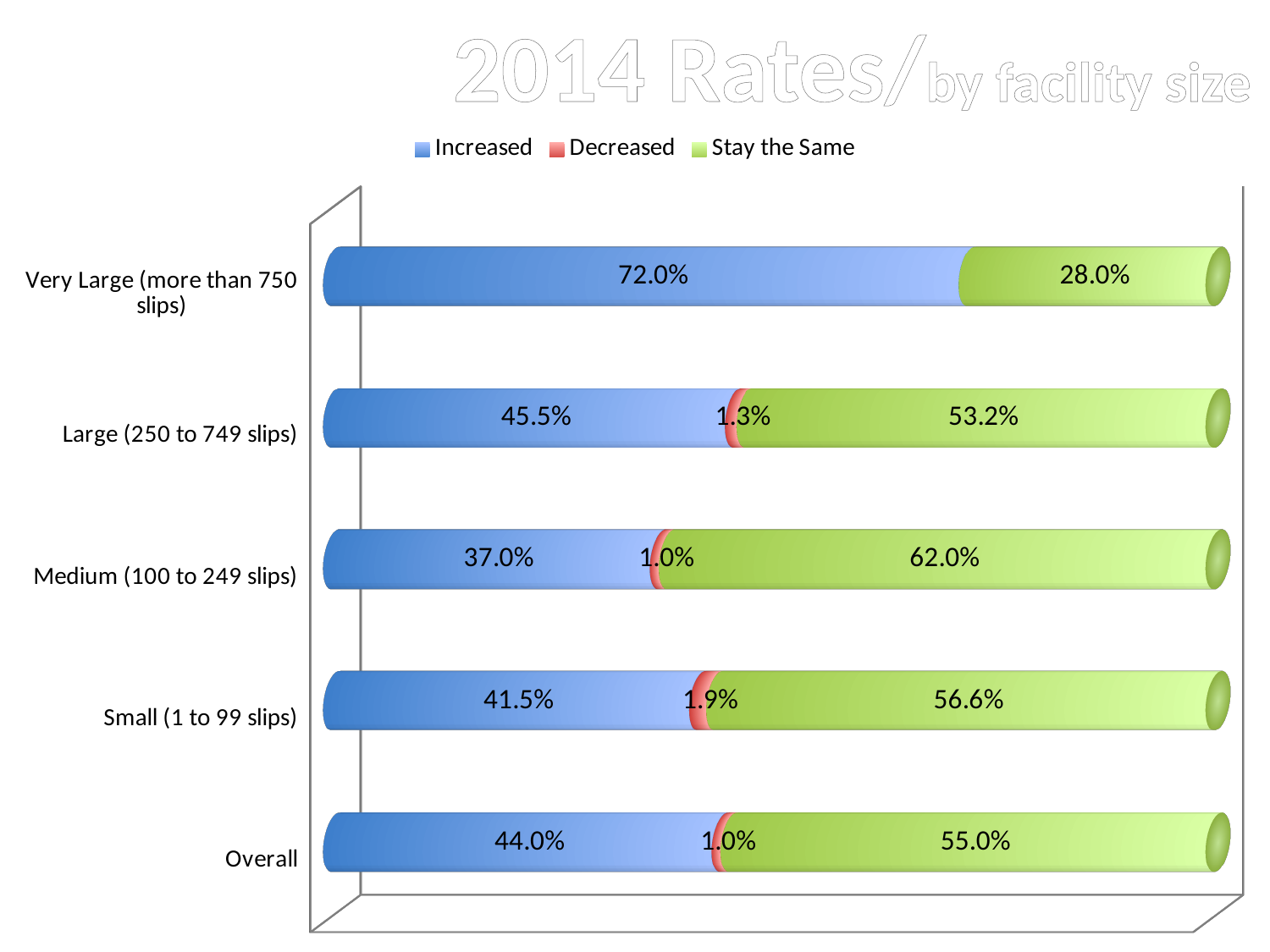
What is the Decreased value for Small facilities (1 to 99 slips)? 1.9% How many series does the legend list? 3 What is the difference between the Stay the Same values for Medium (100 to 249 slips) and Very Large (more than 750 slips)? 34.0% What kind of chart is shown on the slide? Stacked bar chart Which facility size category has the lowest Increased percentage? Medium (100 to 249 slips) Which colour represents the Decreased series in the chart? Red How many facility size categories are shown on the chart? 5 What is the Overall percentage for Increased? 44.0% What percentage of Very Large facilities (more than 750 slips) reported rates Increased? 72.0% What is the Stay the Same value for Medium facilities (100 to 249 slips)? 62.0% Which facility size category has the highest Increased percentage? Very Large (more than 750 slips) Which is larger: the Increased value for Large (250 to 749 slips) or for Small (1 to 99 slips)? Large (250 to 749 slips)